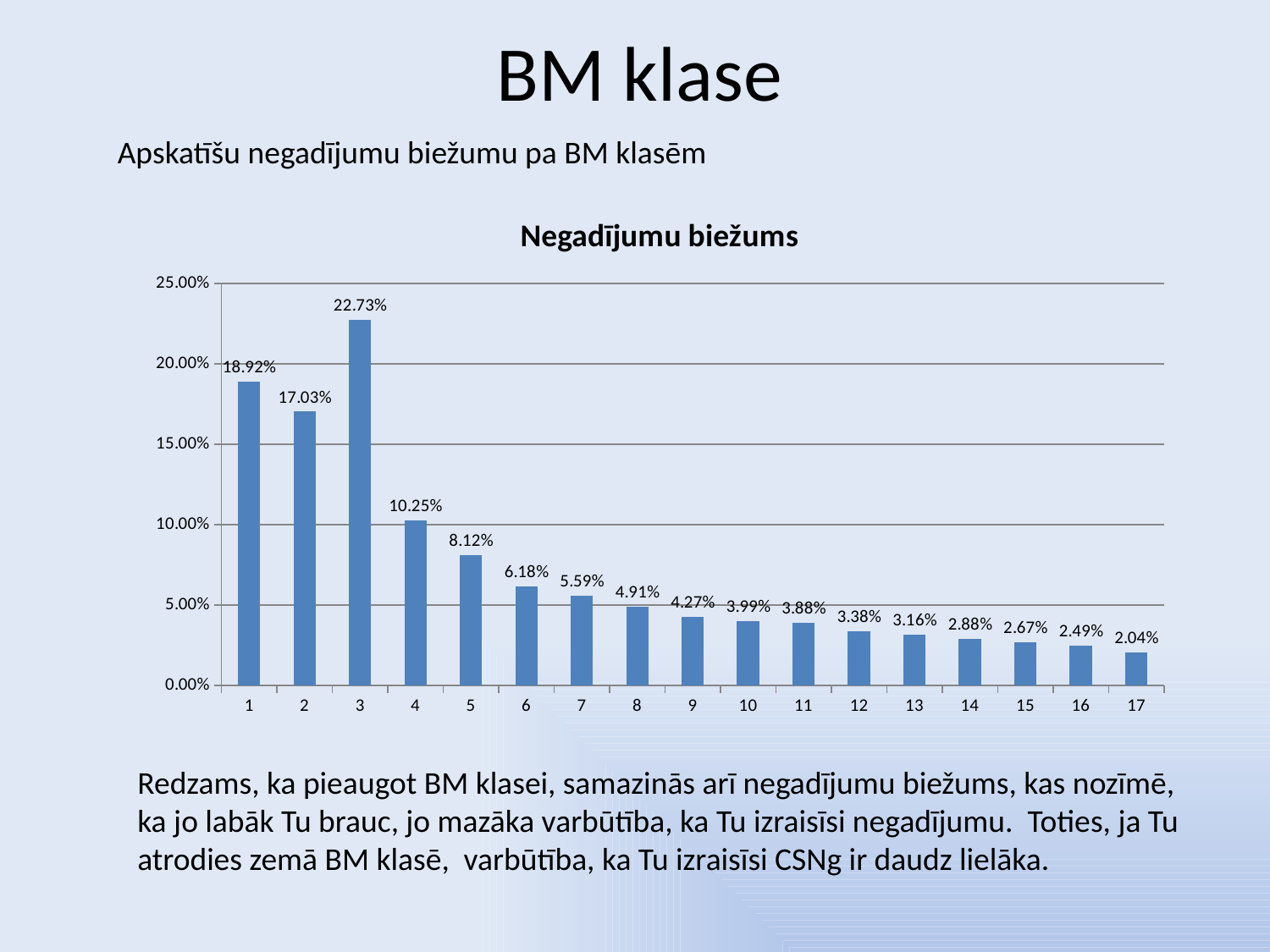
Which category has the lowest value? 17 What is the difference between the values for category 1 and category 2? 1.89% Which is larger, the value for category 4 or category 5? category 4 What kind of chart is shown? bar chart What is the value for category 10? 3.99% Do the values generally rise or fall from category 3 to category 17? fall Is the value for category 6 greater or less than 5.00%? greater What is the value for category 3? 22.73% What is the value for category 17? 2.04% What is the title of the chart? Negadījumu biežums How many categories are shown on the x axis? 17 Which category has the highest value? 3